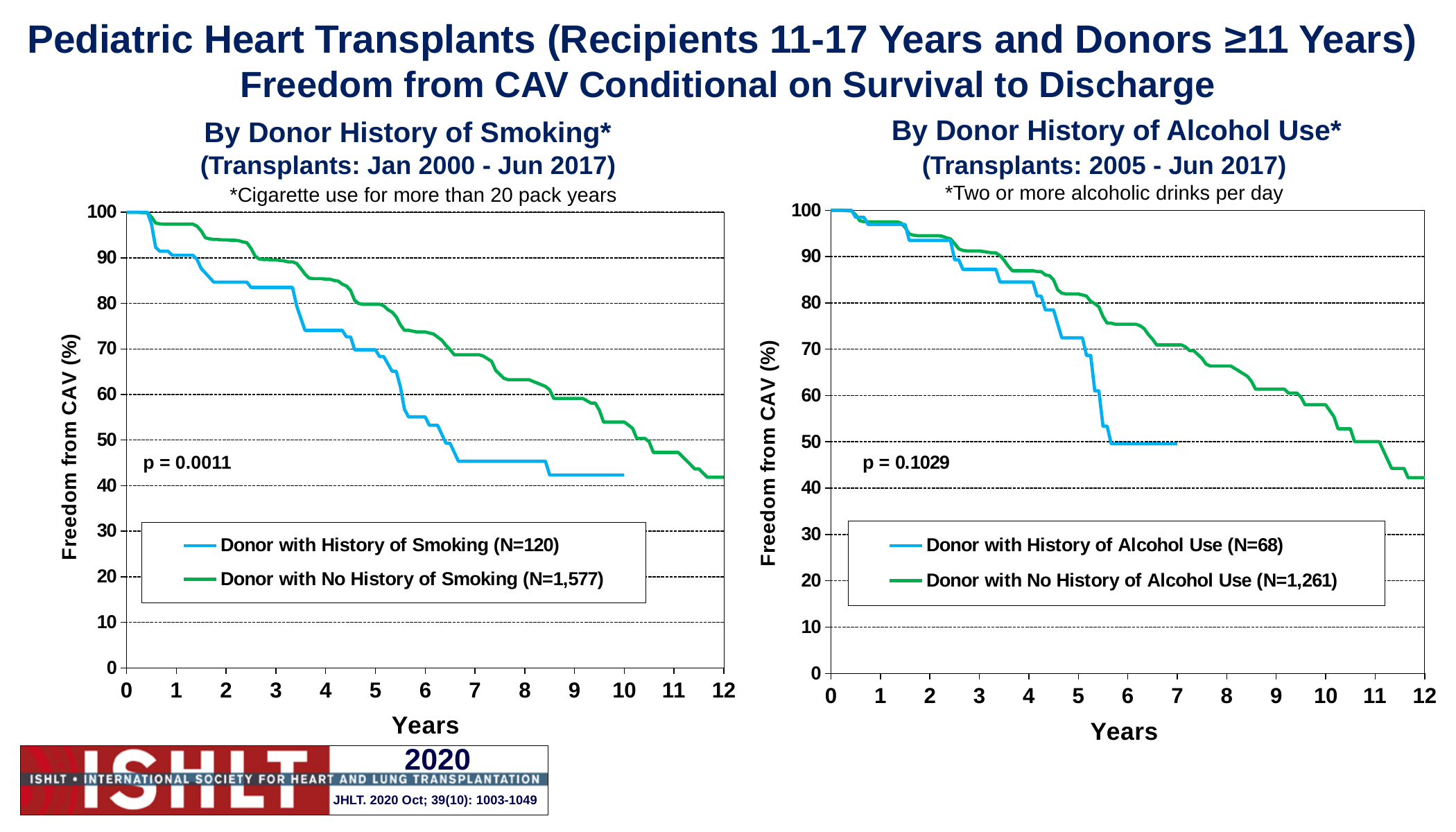
In the right chart, 'By Donor History of Alcohol Use', is the value for donors with no history of alcohol use at 6 years greater or less than 70? greater In the left chart, 'By Donor History of Smoking', is the value for donors with no history of smoking at 6 years greater or less than 70? greater In the right chart, 'By Donor History of Alcohol Use', which series has the higher freedom from CAV at 6 years? Donor with No History of Alcohol Use (N=1,261) How many series does the legend of the right chart, 'By Donor History of Alcohol Use', list? 2 What p-value is shown on the right chart, 'By Donor History of Alcohol Use'? p = 0.1029 In the left chart, 'By Donor History of Smoking', how many patients are in the 'Donor with History of Smoking' group according to the legend? N=120 In the left chart, 'By Donor History of Smoking', which series has the higher freedom from CAV at 6 years? Donor with No History of Smoking (N=1,577) What kind of chart is the left chart, 'By Donor History of Smoking'? line chart In the left chart, 'By Donor History of Smoking', do the values rise or fall as years increase? fall In the left chart, 'By Donor History of Smoking', is the value for donors with a history of smoking at 6 years greater or less than 60? less